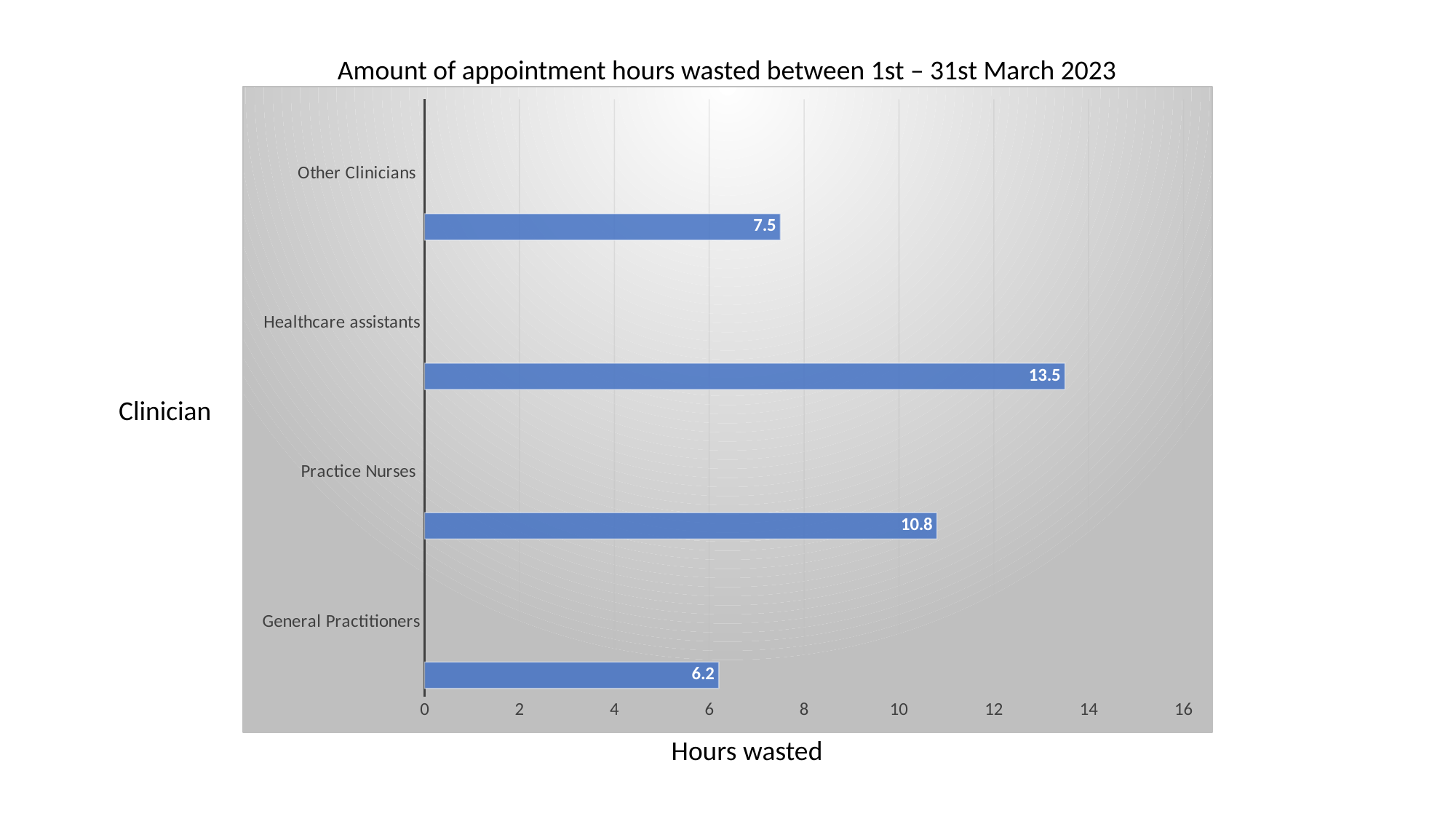
How many hours were wasted by Healthcare assistants? 13.5 Which clinician group wasted the most appointment hours? Healthcare assistants What is the difference in hours wasted between Healthcare assistants and General Practitioners? 7.3 Which wasted more hours, Practice Nurses or Other Clinicians? Practice Nurses Which clinician group wasted the fewest appointment hours? General Practitioners What is the label of the horizontal axis? Hours wasted How many hours were wasted by General Practitioners? 6.2 How many hours were wasted by Practice Nurses? 10.8 What kind of chart is shown on the slide? bar chart How many hours were wasted by Other Clinicians? 7.5 What is the title of the chart? Amount of appointment hours wasted between 1st – 31st March 2023 How many clinician categories are shown in the chart? 4